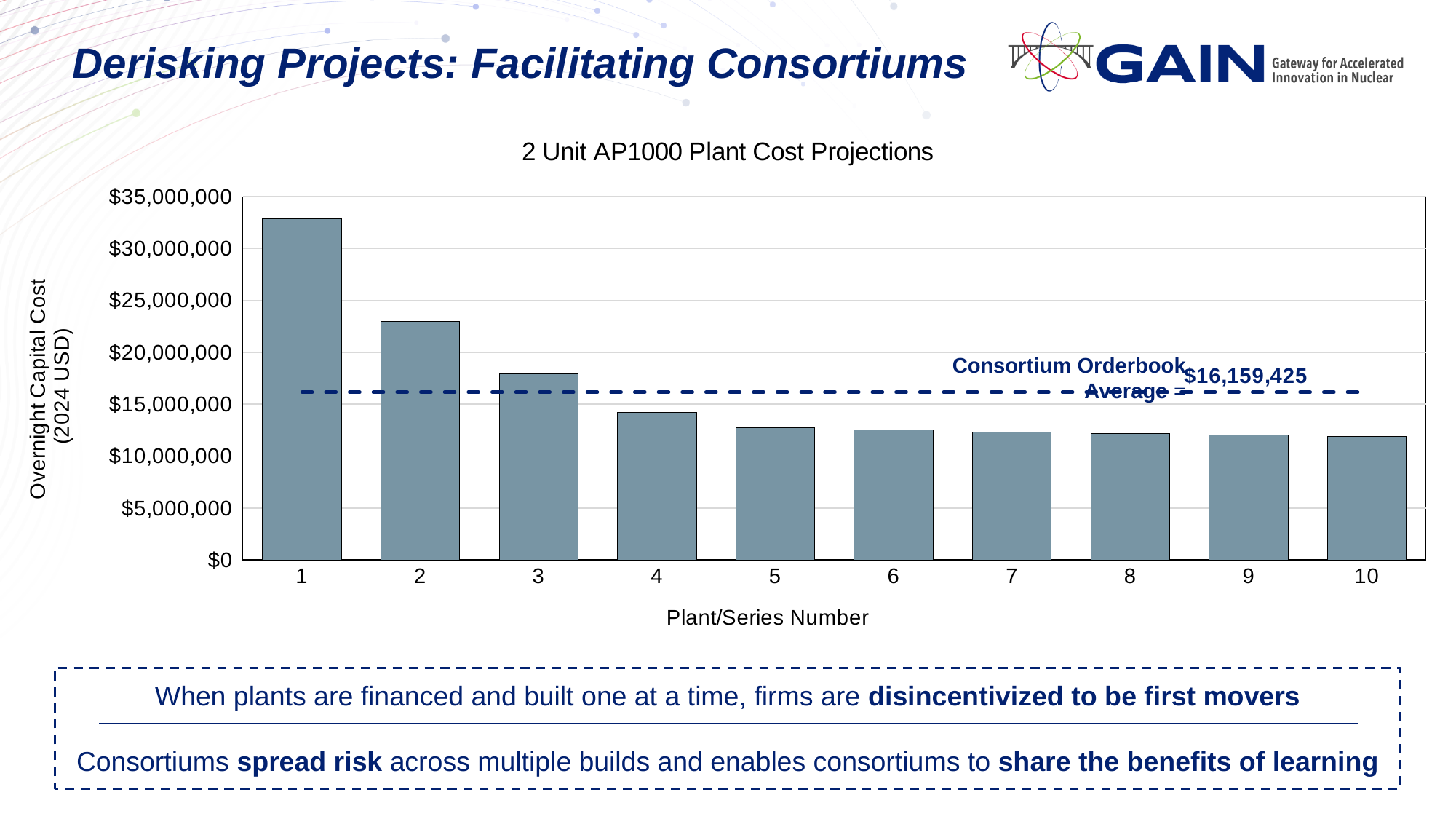
Is the overnight capital cost for plant/series number 1 greater or less than $30,000,000? greater Do the overnight capital costs rise or fall as the plant/series number increases? fall What kind of chart is shown on the slide? bar chart Is the overnight capital cost for plant/series number 3 greater or less than $20,000,000? less Is the overnight capital cost for plant/series number 4 greater or less than $15,000,000? less What is the title of the chart? 2 Unit AP1000 Plant Cost Projections What is the label of the y axis? Overnight Capital Cost (2024 USD) Which has the larger overnight capital cost, plant/series number 2 or plant/series number 5? 2 How many plant/series numbers are plotted on the x axis? 10 Which plant/series number has the highest overnight capital cost? 1 What is the Consortium Orderbook Average value shown by the dashed line? $16,159,425